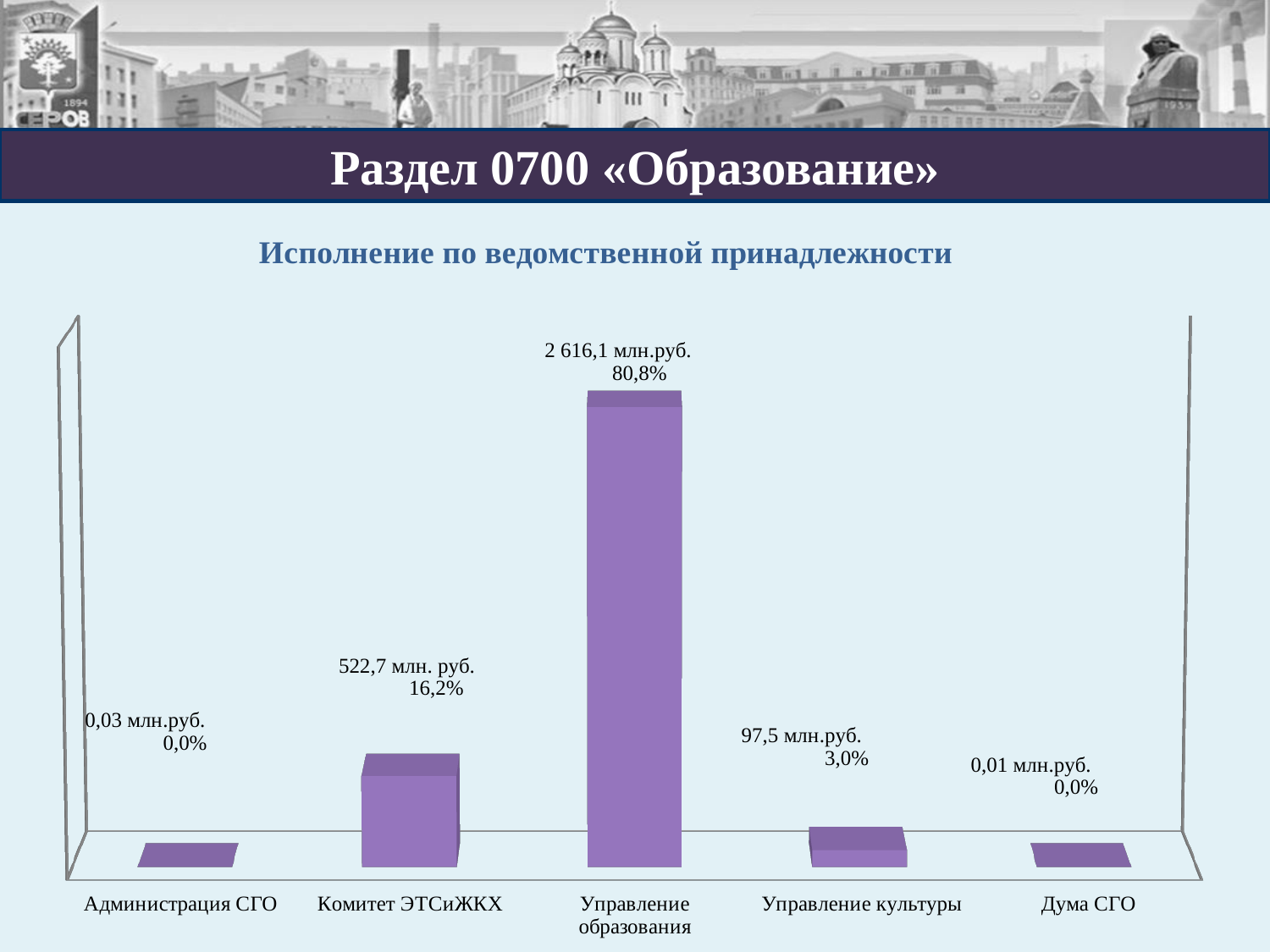
What is the difference in млн.руб. between Управление образования and Комитет ЭТСиЖКХ? 2 093,4 млн.руб. What percentage is shown for Дума СГО? 0,0% What is the title of the chart? Исполнение по ведомственной принадлежности Which is larger, the value for Комитет ЭТСиЖКХ or the value for Управление культуры? Комитет ЭТСиЖКХ What percentage share is shown for Комитет ЭТСиЖКХ? 16,2% What is the value for Администрация СГО? 0,03 млн.руб. How many categories are shown on the chart? 5 Which category has the lowest value? Дума СГО Which category has the highest value? Управление образования What is the value for Управление культуры? 97,5 млн.руб. What is the value for Управление образования? 2 616,1 млн.руб. What kind of chart is shown on the slide? bar chart